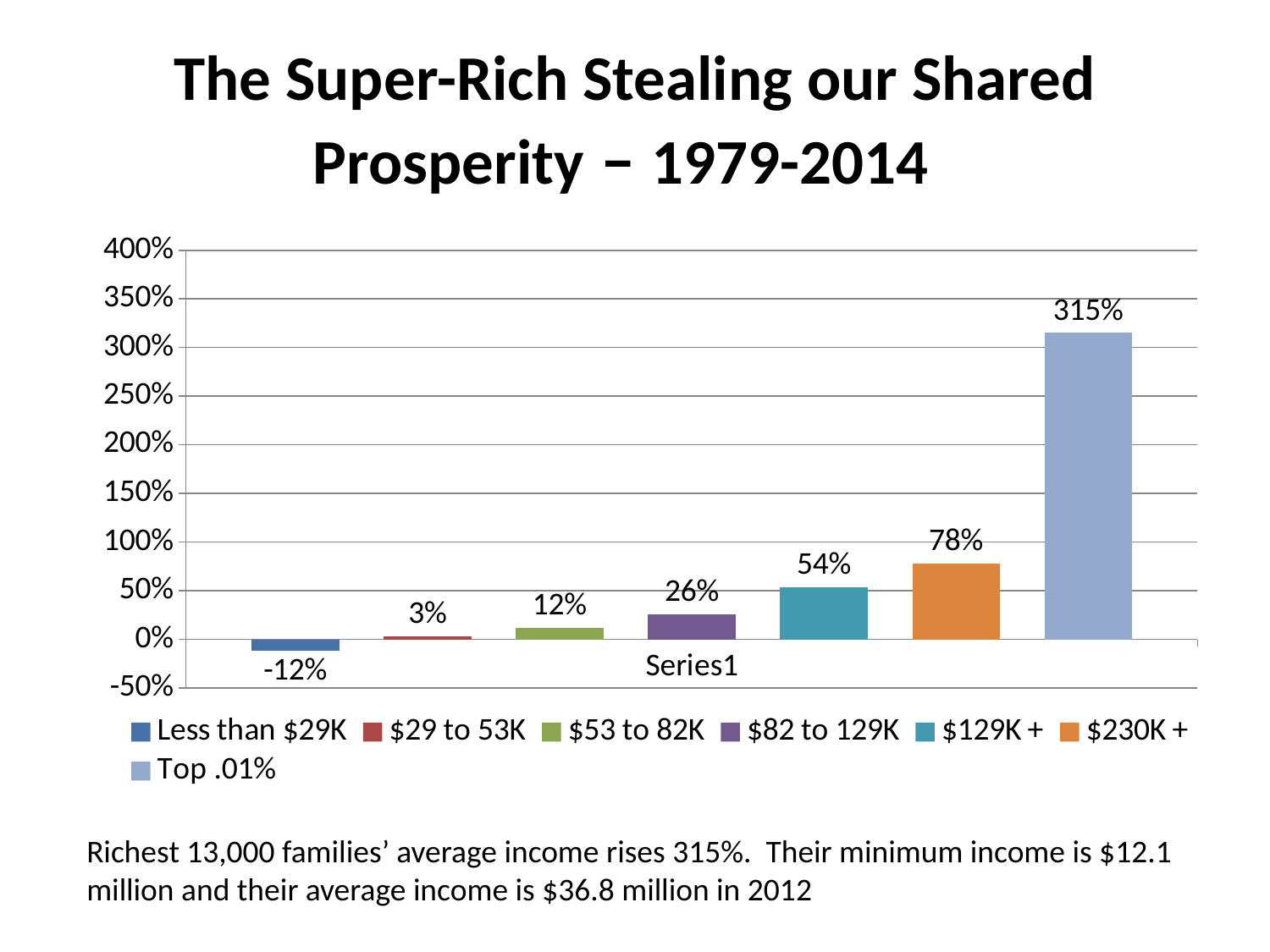
Which income group has the highest value? Top .01% How many bars are plotted in the chart? 7 What is the value for the $230K + bar? 78% What kind of chart is shown on the slide? Bar chart Which is larger, the value for $53 to 82K or the value for $29 to 53K? $53 to 82K What is the difference between the $230K + value and the $129K + value? 24% What is the value for the $82 to 129K bar? 26% Do the values rise or fall moving from left to right across the bars? Rise How many entries does the legend list? 7 What is the value for the Top .01% bar? 315% Which income group has the lowest value? Less than $29K What is the value for the Less than $29K bar? -12%